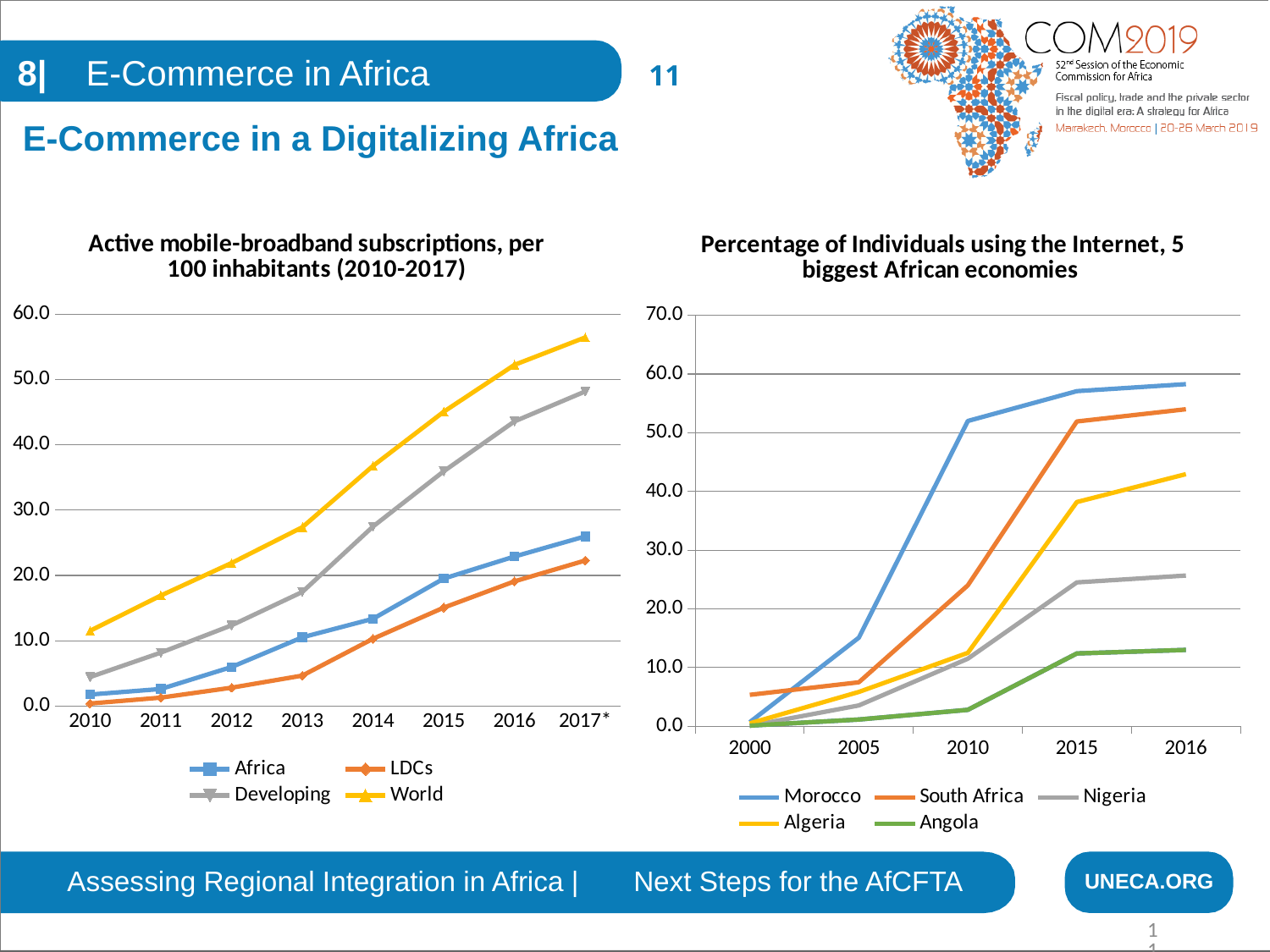
In the 'Percentage of Individuals using the Internet' chart, which country has the lowest value in 2016? Angola In the 'Percentage of Individuals using the Internet' chart, which is larger in 2016, Morocco or Algeria? Morocco In the 'Active mobile-broadband subscriptions' chart, do the values for Developing rise or fall from 2010 to 2017*? rise How many series does the legend of the 'Percentage of Individuals using the Internet, 5 biggest African economies' chart list? 5 In the 'Percentage of Individuals using the Internet' chart, is the value for Nigeria in 2016 greater or less than 30.0? less What kind of chart is the 'Active mobile-broadband subscriptions, per 100 inhabitants (2010-2017)' chart? line chart How many series does the legend of the 'Active mobile-broadband subscriptions' chart list? 4 In the 'Active mobile-broadband subscriptions' chart, which series has the lowest value in 2017*? LDCs In the 'Active mobile-broadband subscriptions' chart, is the value for World in 2017* greater or less than 50.0? greater How many years are plotted on the x axis of the 'Active mobile-broadband subscriptions' chart? 8 In the 'Active mobile-broadband subscriptions' chart, which series has the highest value in 2017*? World In the 'Active mobile-broadband subscriptions' chart, is the value for Africa in 2010 greater or less than 10.0? less